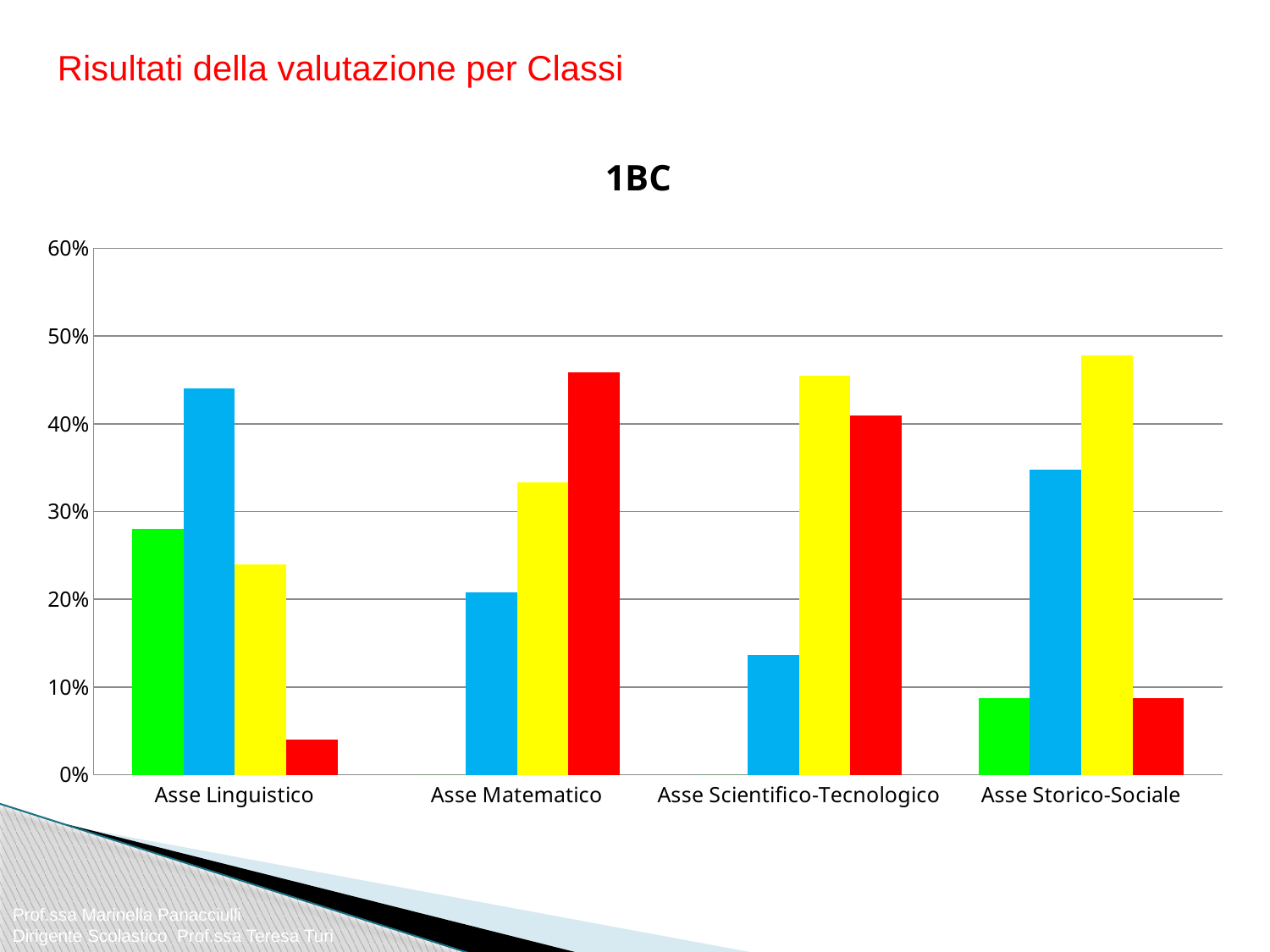
Is the value of the blue bar for Asse Linguistico greater or less than 40%? greater In which category is the red bar the tallest? Asse Matematico Is the value of the red bar for Asse Linguistico greater or less than 10%? less How many categories are shown on the x axis of the chart? 4 Is the value of the red bar for Asse Matematico greater or less than 40%? greater How many differently coloured bar series appear in the chart? 4 What is the title of the chart? 1BC For Asse Matematico, which is larger: the red bar or the blue bar? the red bar Which coloured bar is the tallest for Asse Storico-Sociale? yellow What type of chart is shown on the slide? bar chart